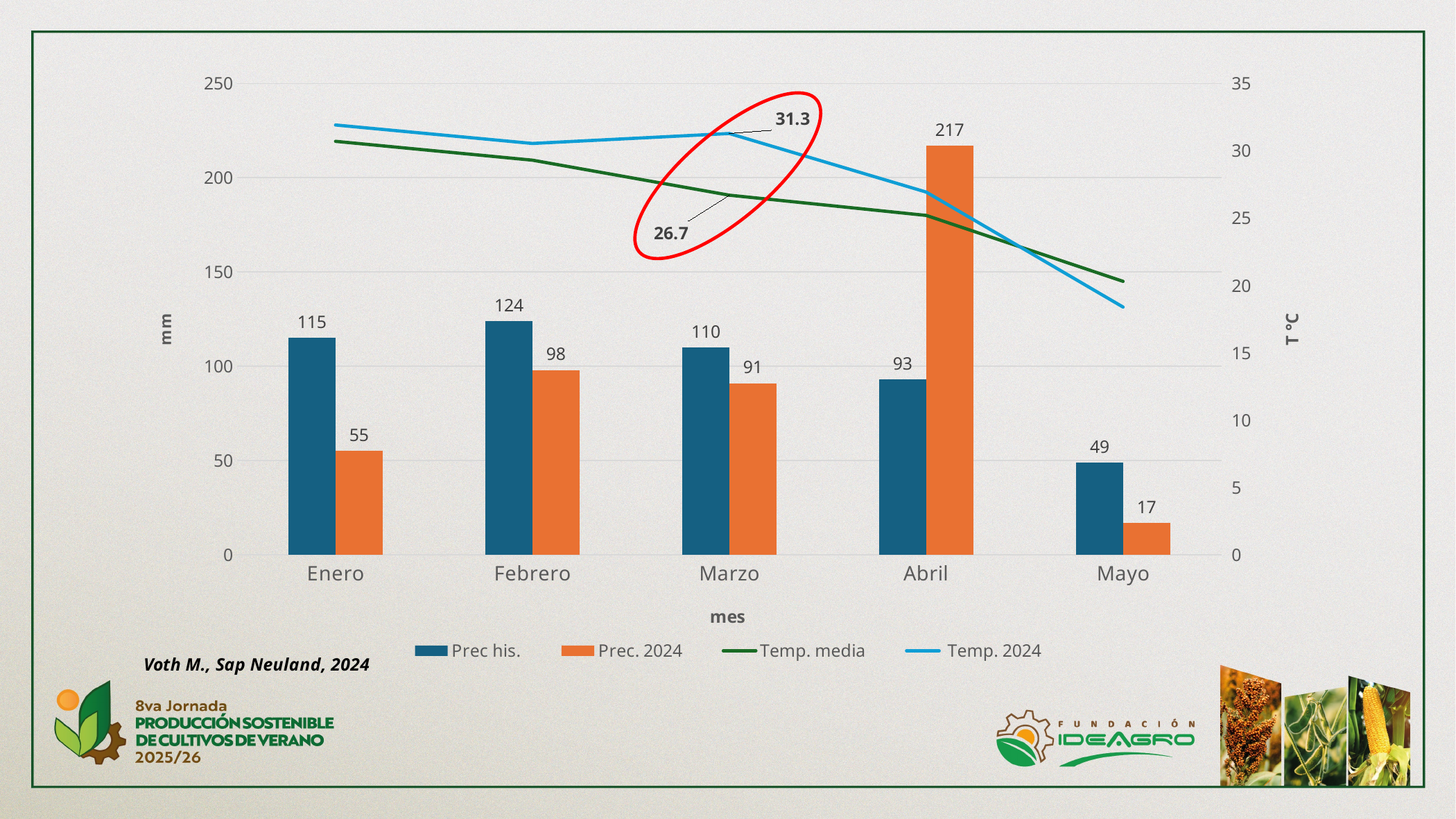
Which month has the lowest Prec. 2024 value? Mayo Which is larger for Febrero, Prec his. or Prec. 2024? Prec his. What is the difference between Prec. 2024 and Prec his. for Abril? 124 How many months are shown on the x axis? 5 Is the Temp. 2024 value for Enero greater or less than 30? greater What is the labelled Temp. 2024 value for Marzo? 31.3 What is the labelled Temp. media value for Marzo? 26.7 What is the value of Prec his. for Enero? 115 Which month has the highest Prec his. value? Febrero What is the value of Prec. 2024 for Abril? 217 What is the value of Prec. 2024 for Mayo? 17 How many series does the legend list? 4